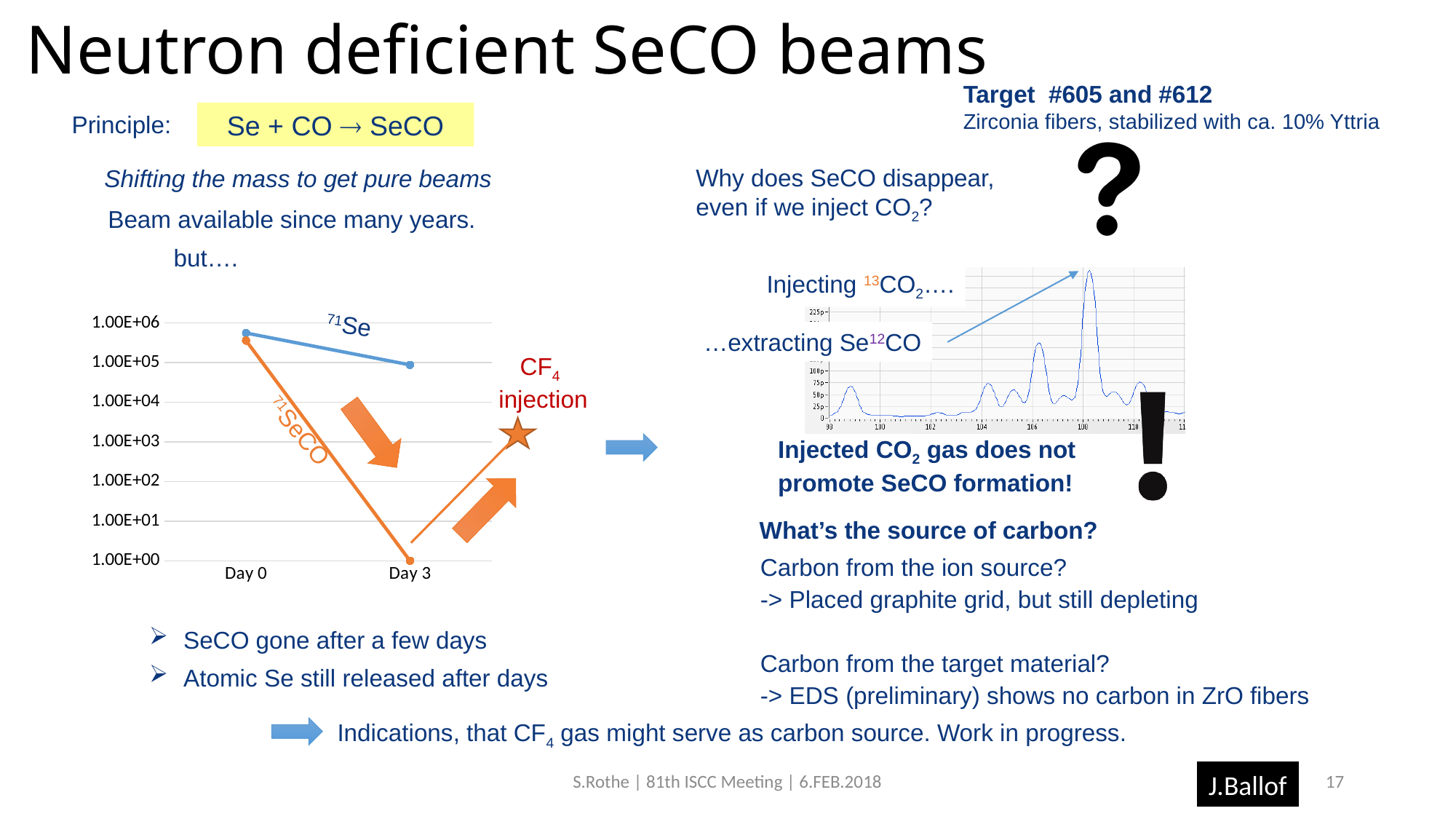
In the line chart on the left, does the 71SeCO series rise or fall from Day 0 to Day 3? fall In the line chart on the left, which series is drawn in orange? 71SeCO In the line chart on the left, is the value for 71Se at Day 3 greater or less than 1.00E+04? greater In the line chart on the left, which series has the larger value at Day 3, 71Se or 71SeCO? 71Se In the line chart on the left, does the 71Se series rise or fall from Day 0 to Day 3? fall In the line chart on the left, what is the value of 71SeCO at Day 3? 1.00E+00 What kind of chart is shown on the left of the slide? line chart How many x-axis categories does the line chart on the left have? 2 In the line chart on the left, is the value for 71SeCO at Day 0 greater or less than 1.00E+04? greater How many data series are plotted in the line chart on the left? 2 In the line chart on the left, is the value for 71Se at Day 0 greater or less than 1.00E+05? greater What are the x-axis categories of the line chart on the left? Day 0, Day 3